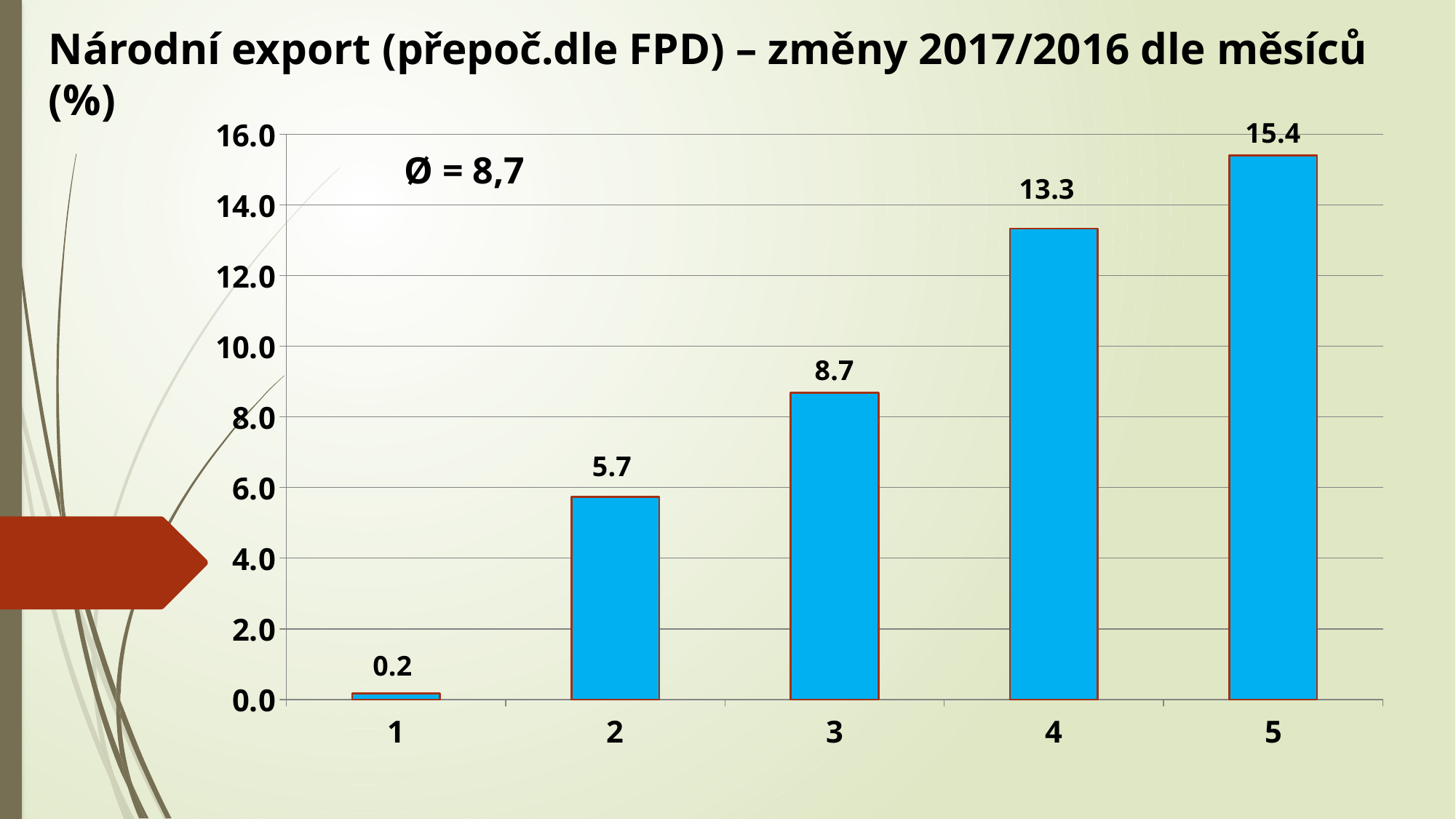
Which month has the lowest value? 1 Is the value for month 4 greater or less than 12.0? greater What is the value for month 5? 15.4 Which is larger, the value for month 2 or the value for month 4? month 4 What kind of chart is shown on the slide? bar chart Which month has the highest value? 5 What is the value for month 3? 8.7 Do the values rise or fall from month 1 to month 5? rise What is the difference between the values for month 3 and month 2? 3.0 What is the value for month 1? 0.2 How many months are shown on the x axis? 5 What is the difference between the values for month 5 and month 4? 2.1